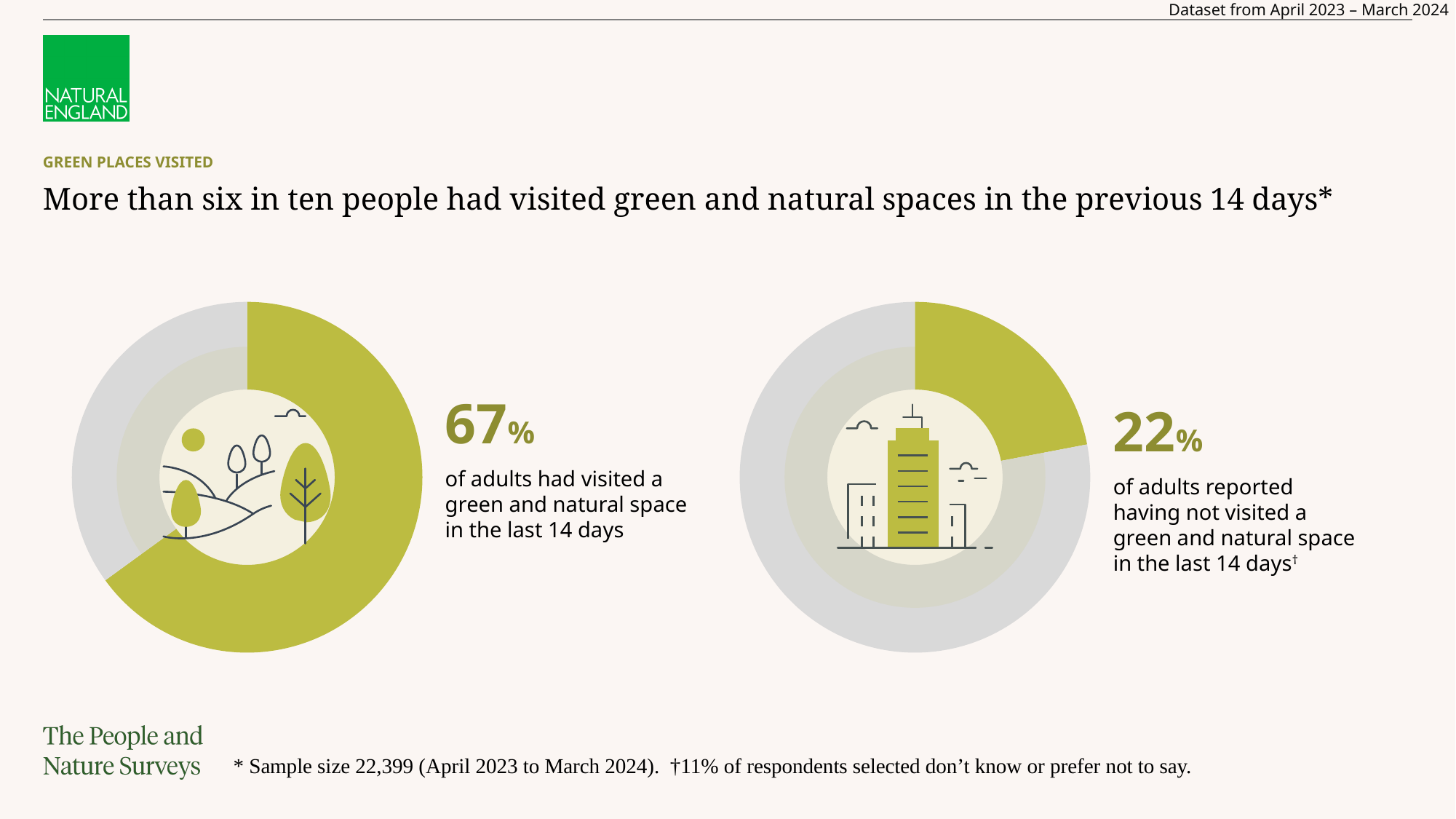
On the right chart, is the highlighted share of adults who had not visited a green and natural space greater or less than 25%? less What kind of chart is used on the right side of the slide to show the 22% figure? Donut (pie) chart According to the footnote, what percentage of respondents selected don't know or prefer not to say? 11% What is the sample size stated in the footnote for the charts on the slide? 22,399 On the left chart, is the highlighted share of adults who had visited a green and natural space greater or less than 50%? greater What is the difference in percentage points between the 67% on the left chart and the 22% on the right chart? 45 percentage points What kind of chart is used on the left side of the slide to show the 67% figure? Donut (pie) chart On the right chart, what percentage of adults reported having not visited a green and natural space in the last 14 days? 22% Which is larger: the share of adults who had visited a green and natural space (left chart) or the share who had not (right chart)? The share who had visited (67%) On the left chart, what percentage of adults had visited a green and natural space in the last 14 days? 67% How many donut charts are shown on the slide? 2 What colour is used for the highlighted segment in both donut charts? Green (olive/lime green)